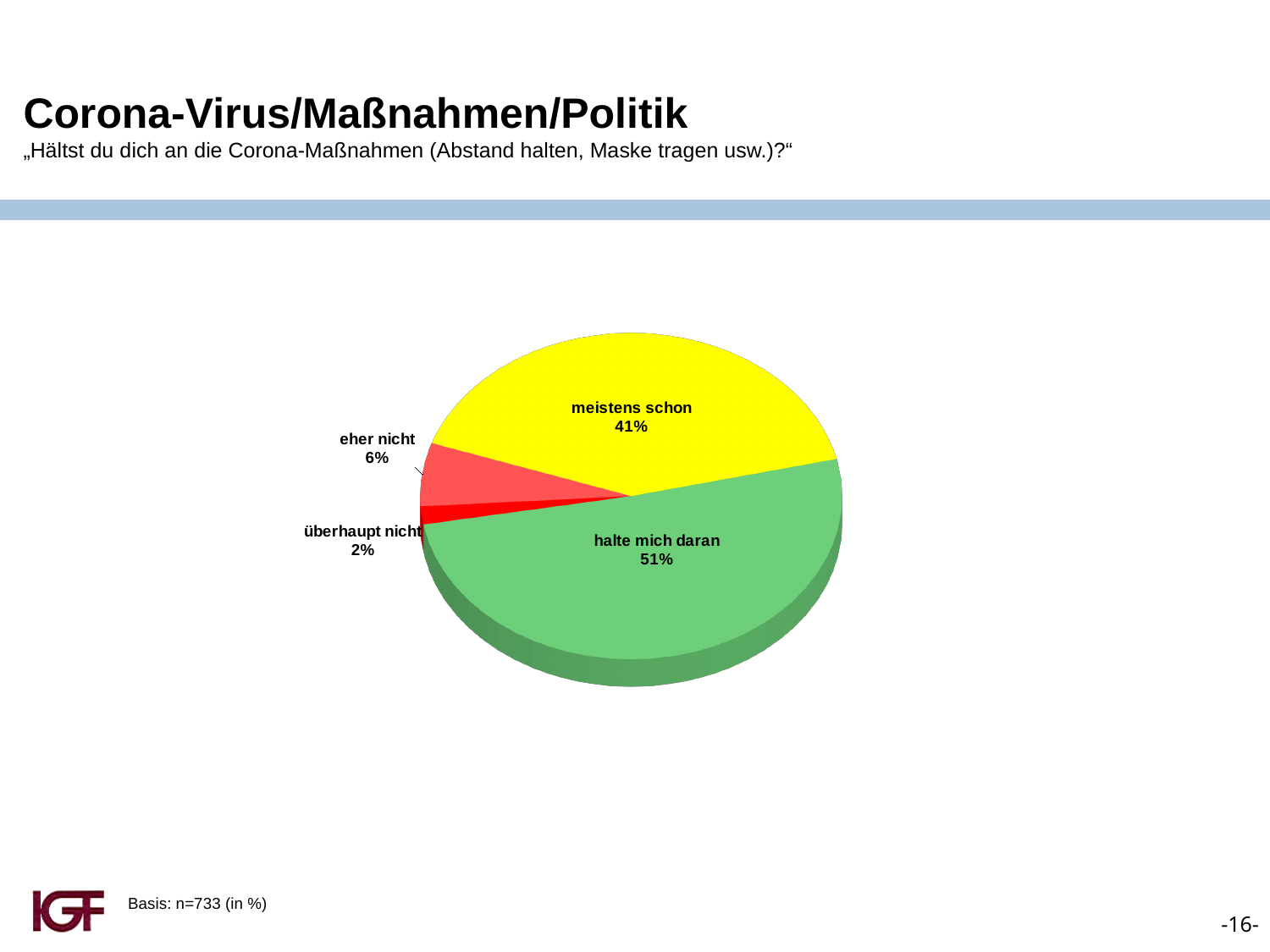
Which is larger: the share for "eher nicht" or the share for "überhaupt nicht"? eher nicht Which answer category has the largest share of the pie? halte mich daran What percentage of respondents answered "halte mich daran"? 51% Which answer category has the smallest share of the pie? überhaupt nicht What colour is the slice for "halte mich daran"? green What percentage of respondents answered "eher nicht"? 6% What is the difference in percentage points between "halte mich daran" and "meistens schon"? 10 What is the sample size (Basis) stated on the slide? n=733 What type of chart is shown on the slide? pie chart What percentage of respondents answered "meistens schon"? 41% What percentage of respondents answered "überhaupt nicht"? 2% How many categories are shown in the pie chart? 4